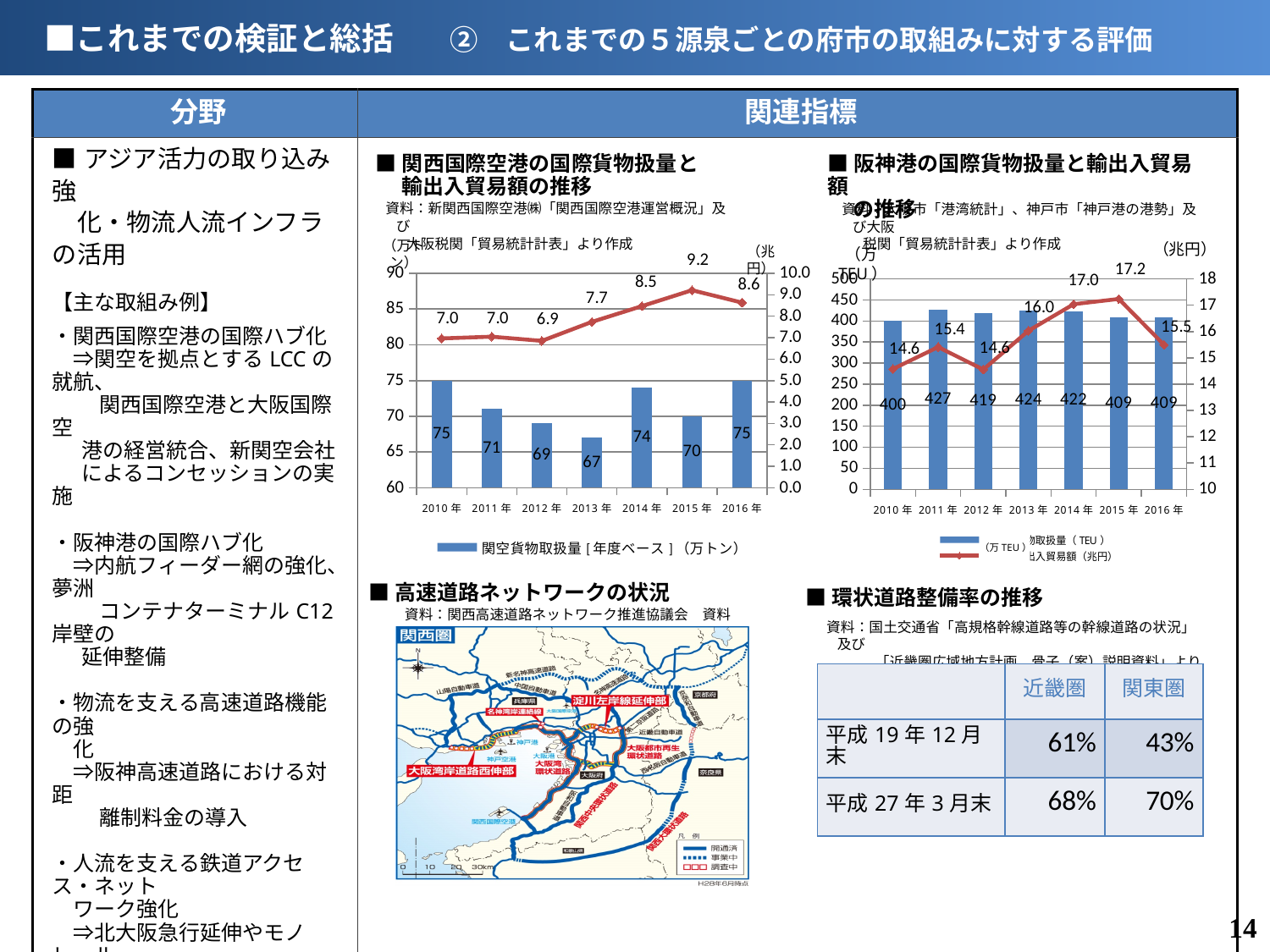
In the chart titled 関西国際空港の国際貨物扱量と輸出入貿易額の推移, how many years are shown on the x axis? 7 In the chart titled 阪神港の国際貨物扱量と輸出入貿易額の推移, what is the difference between the cargo volume in 2011年 and in 2010年? 27 In the chart titled 阪神港の国際貨物扱量と輸出入貿易額の推移, does the trade value line rise or fall from 2015年 to 2016年? fall In the chart titled 関西国際空港の国際貨物扱量と輸出入貿易額の推移, is the cargo volume bar for 2011年 larger or smaller than the bar for 2014年? smaller In the chart titled 関西国際空港の国際貨物扱量と輸出入貿易額の推移, what is the trade value (line) for 2015年? 9.2 In the chart titled 関西国際空港の国際貨物扱量と輸出入貿易額の推移, what is the difference between the trade value in 2015年 and in 2016年? 0.6 What type of chart is the chart titled 阪神港の国際貨物扱量と輸出入貿易額の推移? Combined bar and line chart In the chart titled 阪神港の国際貨物扱量と輸出入貿易額の推移, what is the trade value (line) for 2014年? 17.0 In the chart titled 阪神港の国際貨物扱量と輸出入貿易額の推移, which year has the highest trade value on the line? 2015年 In the chart titled 関西国際空港の国際貨物扱量と輸出入貿易額の推移, which year has the lowest cargo volume bar? 2013年 In the chart titled 阪神港の国際貨物扱量と輸出入貿易額の推移, what is the cargo volume (bar) for 2011年? 427 In the chart titled 関西国際空港の国際貨物扱量と輸出入貿易額の推移, what is the cargo volume (bar) for 2013年? 67